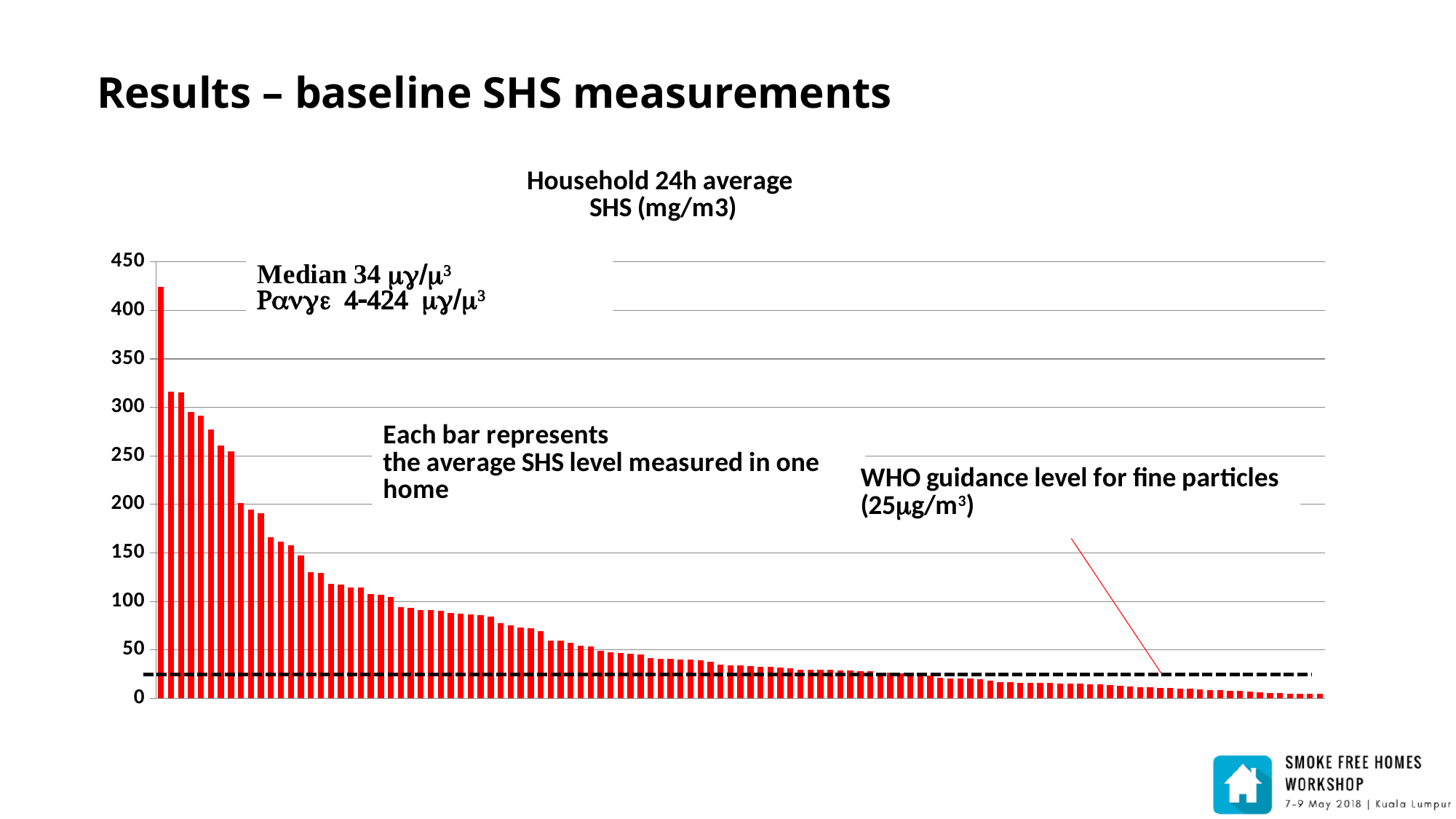
What does the horizontal dashed line on the chart represent? WHO guidance level for fine particles (25µg/m³) What kind of chart is shown on the slide? bar chart Is the value of the second bar from the left greater or less than 300? greater Is the value of the rightmost bar greater or less than 50? less Is the value of the tallest bar greater or less than 450? less What is the title of the chart? Household 24h average SHS (mg/m3) Where on the chart is the tallest bar located? far left Do the bar values rise or fall from left to right across the chart? fall